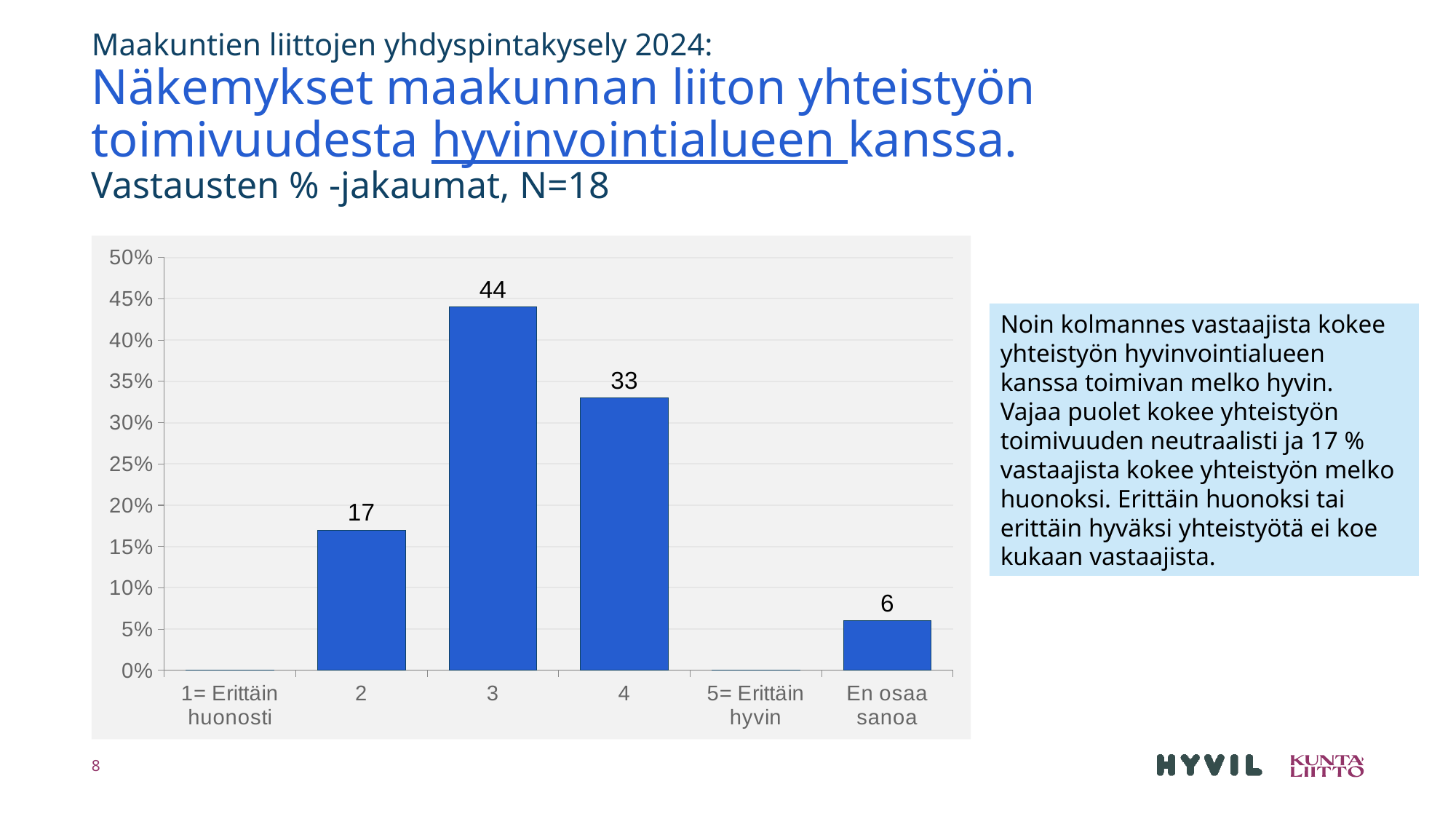
What is the value for category 3? 44 What kind of chart is shown on the slide? bar chart Which category has the highest value? 3 Which is larger, the value for category 2 or the value for 'En osaa sanoa'? 2 What is the total of the values for categories 2, 3 and 4? 94 What is the value for category 2? 17 What is the difference between the values for category 3 and category 4? 11 Is the value for category 4 greater or less than 30%? greater What is the N (number of respondents) stated in the slide subtitle? 18 How many categories are shown on the x axis? 6 What is the value for 'En osaa sanoa'? 6 What is the value for category 4? 33